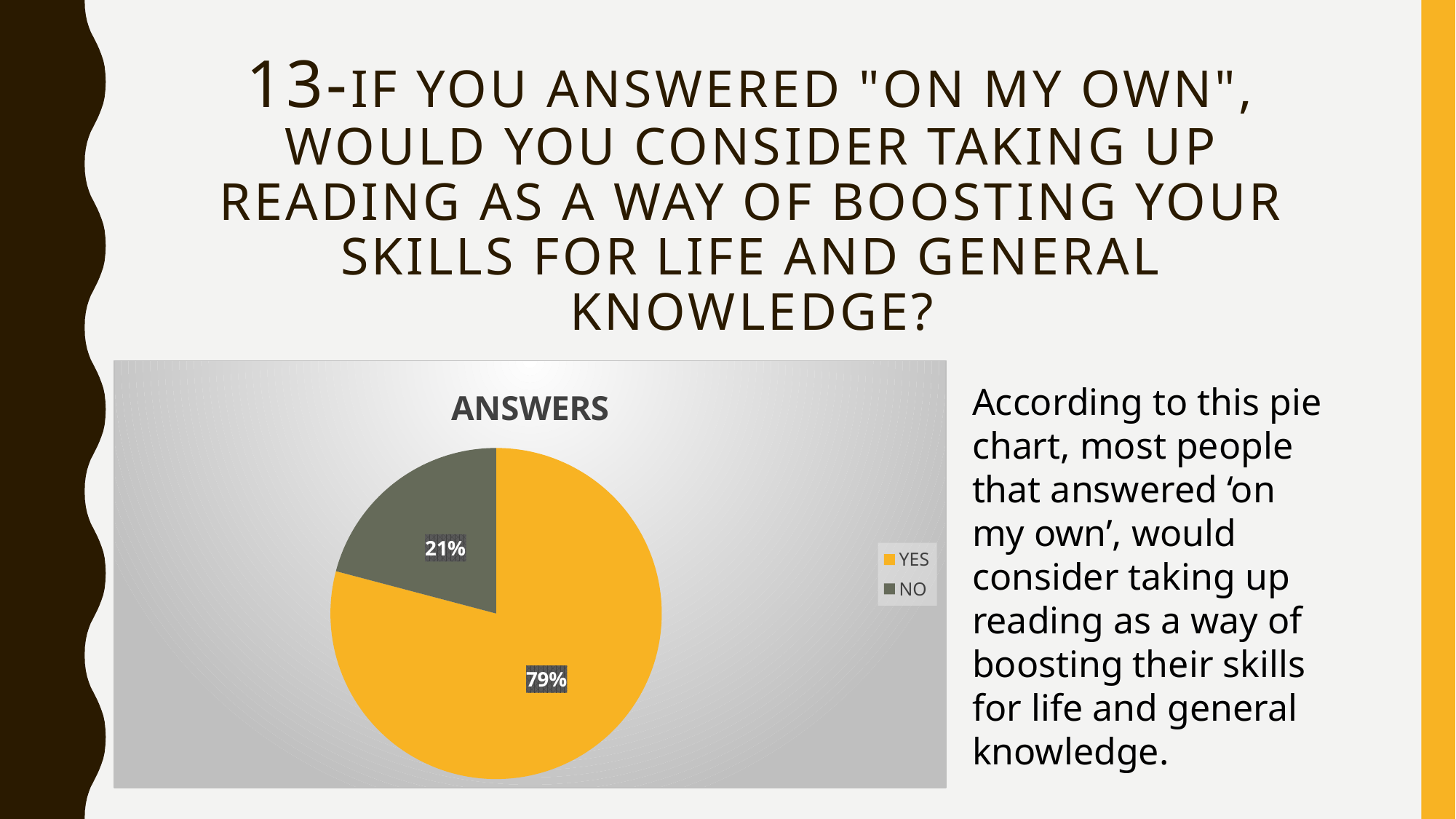
What percentage of answers were NO? 21% What kind of chart is shown on the slide? pie chart What is the chart's title? ANSWERS What share of the pie does the NO slice represent? 21% Which slice is larger, YES or NO? YES How many entries does the legend list? 2 How many slices does the pie chart have? 2 What is the difference in percentage points between the YES and NO slices? 58 What colour is the YES slice? yellow Which answer has the largest share of the pie? YES What percentage of answers were YES? 79% Which answer has the smallest share of the pie? NO